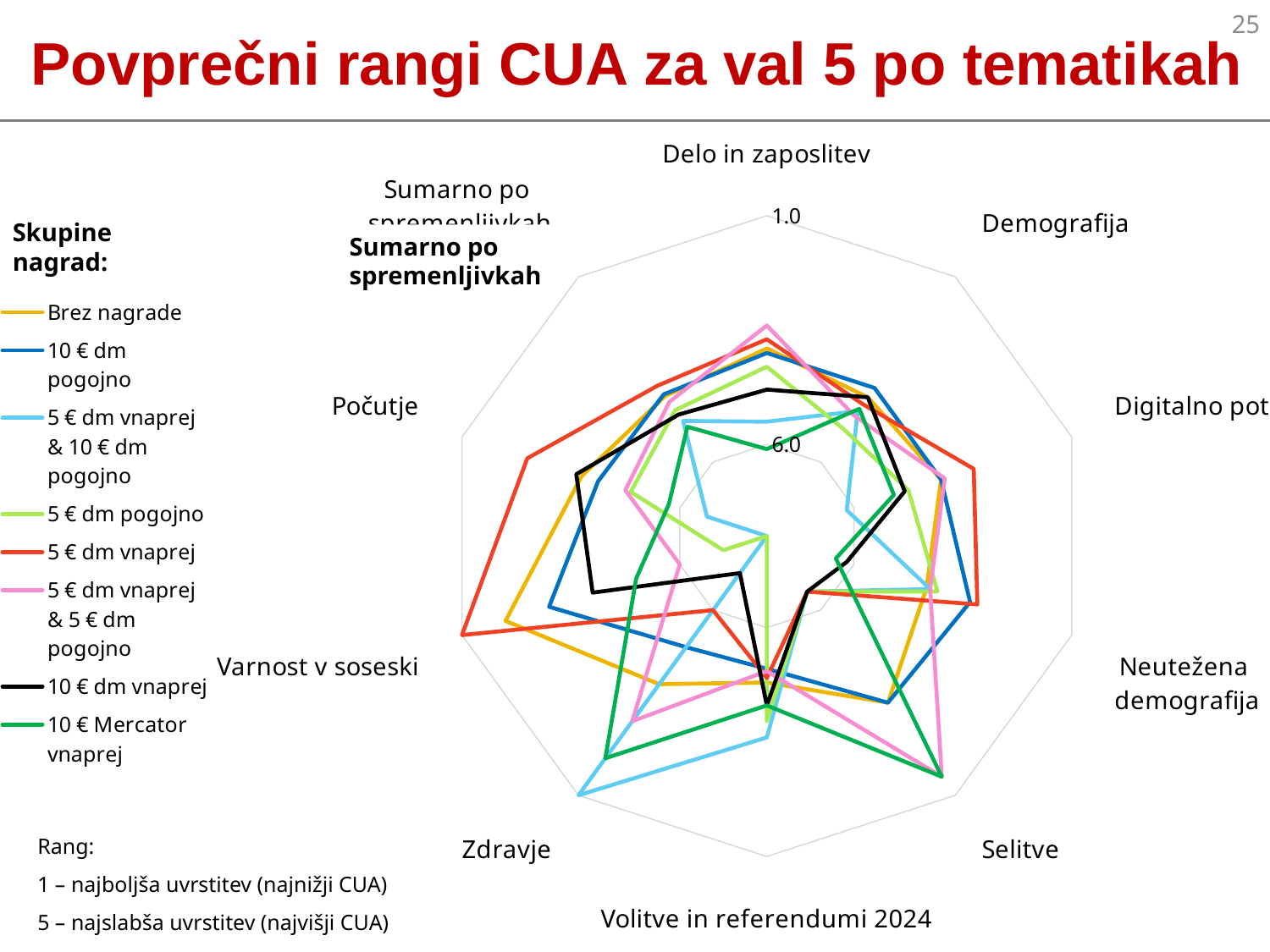
How many series does the legend list? 8 On the Zdravje axis, which series has the lowest rank value (lies farthest from the centre, nearest the 1.0 ring)? 5 € dm vnaprej & 10 € dm pogojno What kind of chart is shown on the slide? radar chart What value is labelled at the centre of the radar chart? 6.0 How many categories (axes) does the radar chart have? 10 On the Varnost v soseski axis, which series has the lowest rank value (lies farthest from the centre, nearest the 1.0 ring)? 5 € dm vnaprej What is the title of the slide containing the chart? Povprečni rangi CUA za val 5 po tematikah